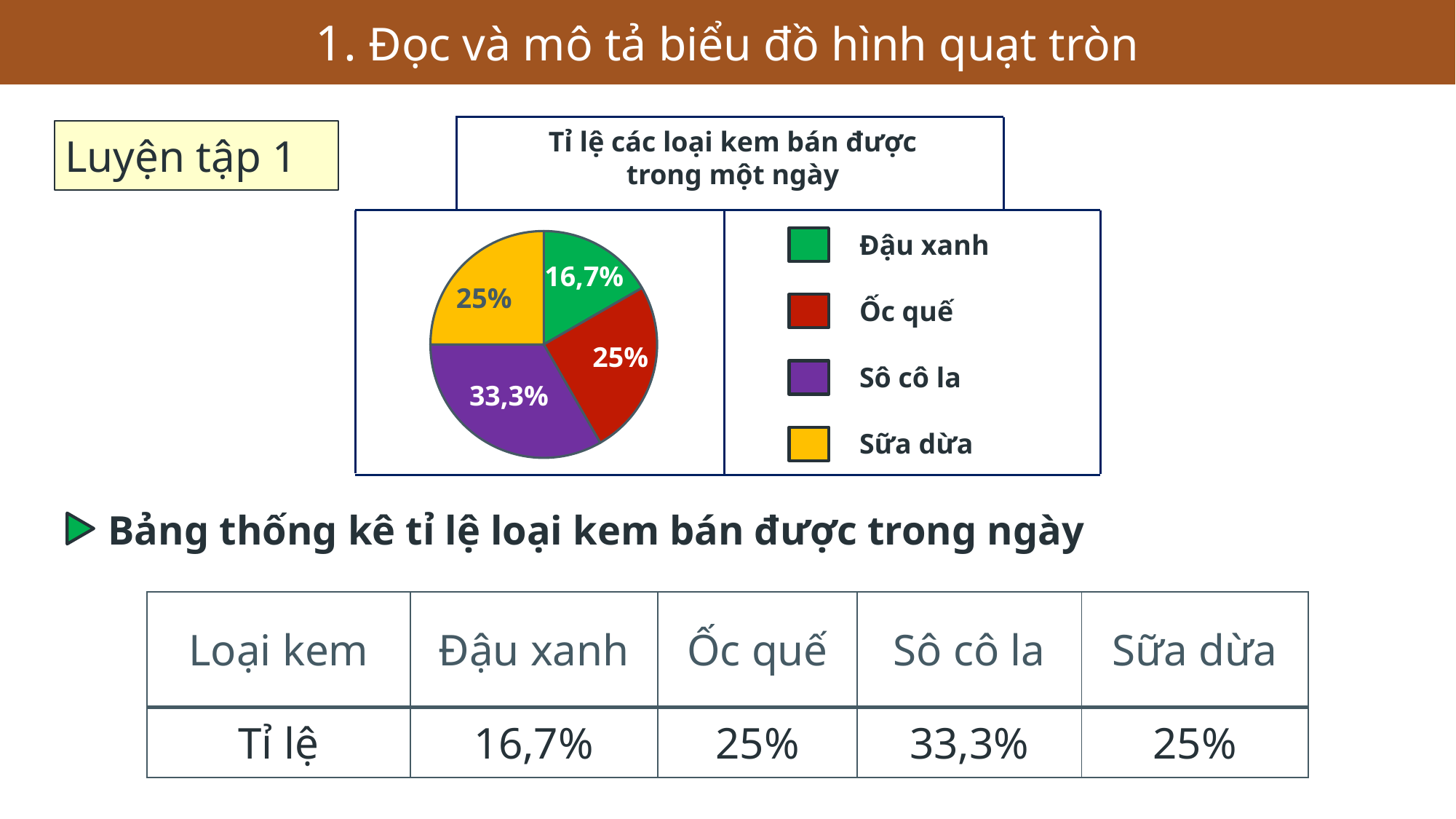
How many entries does the legend list? 4 What is the title of the pie chart? Tỉ lệ các loại kem bán được trong một ngày What share of the pie does Đậu xanh have? 16,7% What colour represents Sữa dừa in the pie chart? yellow How many slices does the pie chart have? 4 Which ice cream type has the smallest share of the pie? Đậu xanh What share of the pie does Sô cô la have? 33,3% What share of the pie does Sữa dừa have? 25% Which ice cream type has the largest share of the pie? Sô cô la What kind of chart is shown on the slide? pie chart Which is larger, the share for Sô cô la or the share for Đậu xanh? Sô cô la